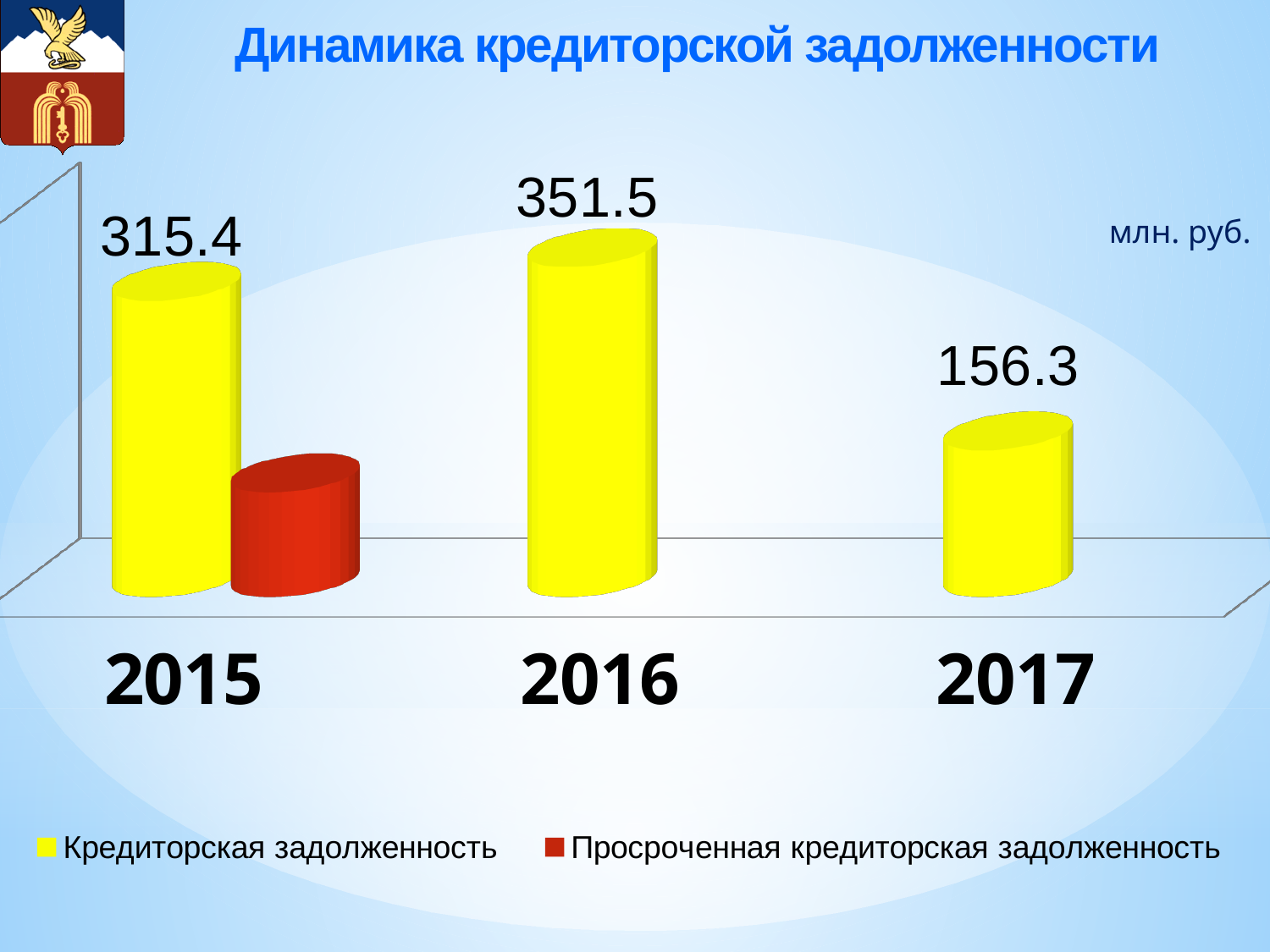
In 2015, which is larger: Кредиторская задолженность or Просроченная кредиторская задолженность? Кредиторская задолженность By how much did Кредиторская задолженность fall from 2016 to 2017? 195.2 In which year is Кредиторская задолженность the highest? 2016 What kind of chart is shown on the slide? Bar chart What is the value of Кредиторская задолженность for 2017? 156.3 In which year is Кредиторская задолженность the lowest? 2017 What is the difference between Кредиторская задолженность in 2016 and in 2015? 36.1 Does Кредиторская задолженность rise or fall from 2016 to 2017? Fall How many years are shown on the x axis? 3 What is the value of Кредиторская задолженность for 2016? 351.5 How many series does the legend list? 2 What is the value of Кредиторская задолженность for 2015? 315.4